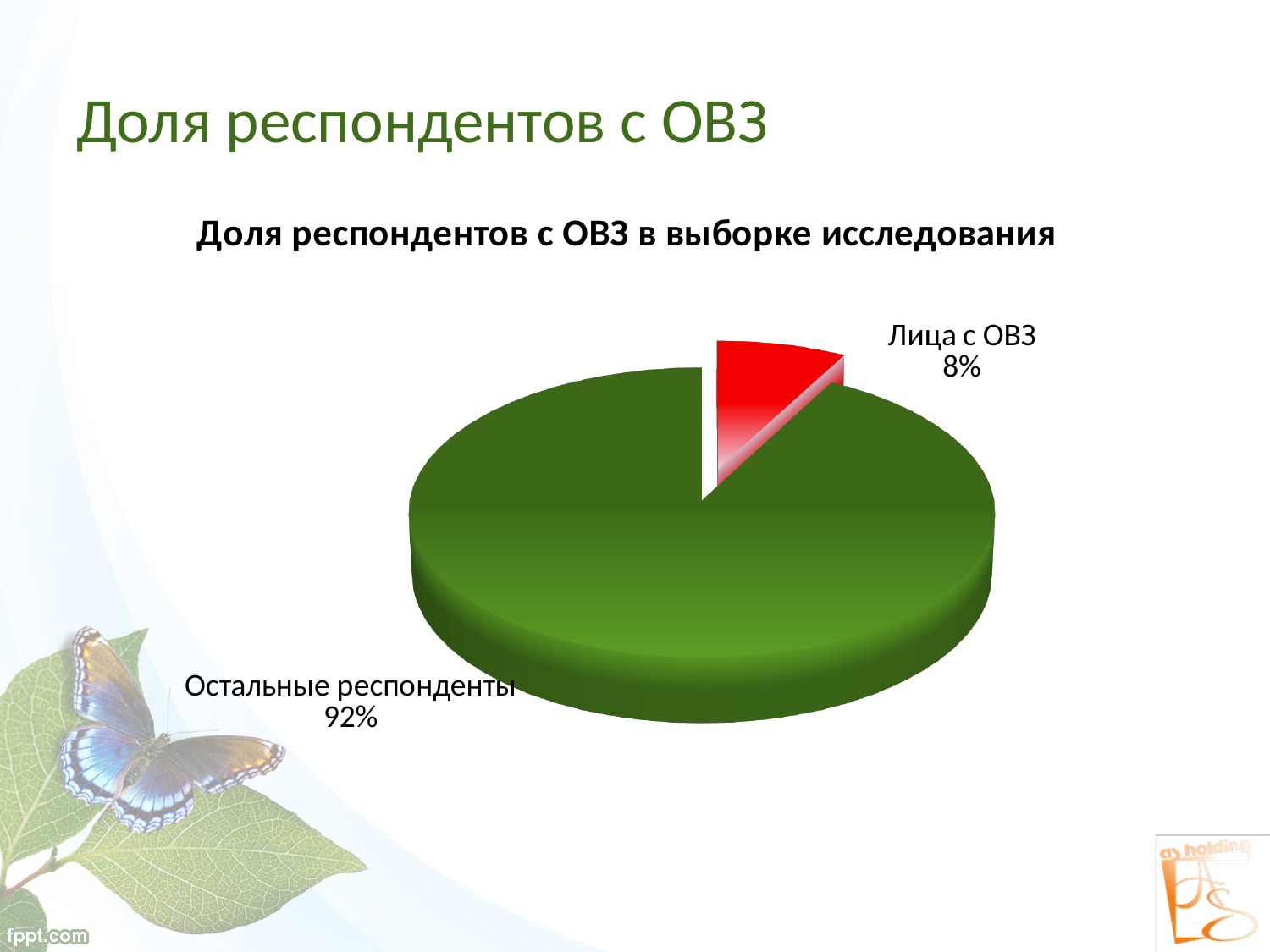
What share of the pie is labelled "Лица с ОВЗ"? 8% Which slice of the pie is the largest? Остальные респонденты What is the difference in percentage points between "Остальные респонденты" and "Лица с ОВЗ"? 84 What share of the pie is labelled "Остальные респонденты"? 92% Which slice of the pie is the smallest? Лица с ОВЗ What kind of chart is shown on the slide? pie chart How many slices does the pie chart have? 2 What is the title of the chart? Доля респондентов с ОВЗ в выборке исследования What colour is the slice for "Лица с ОВЗ"? red Which is larger, the share for "Лица с ОВЗ" or the share for "Остальные респонденты"? Остальные респонденты